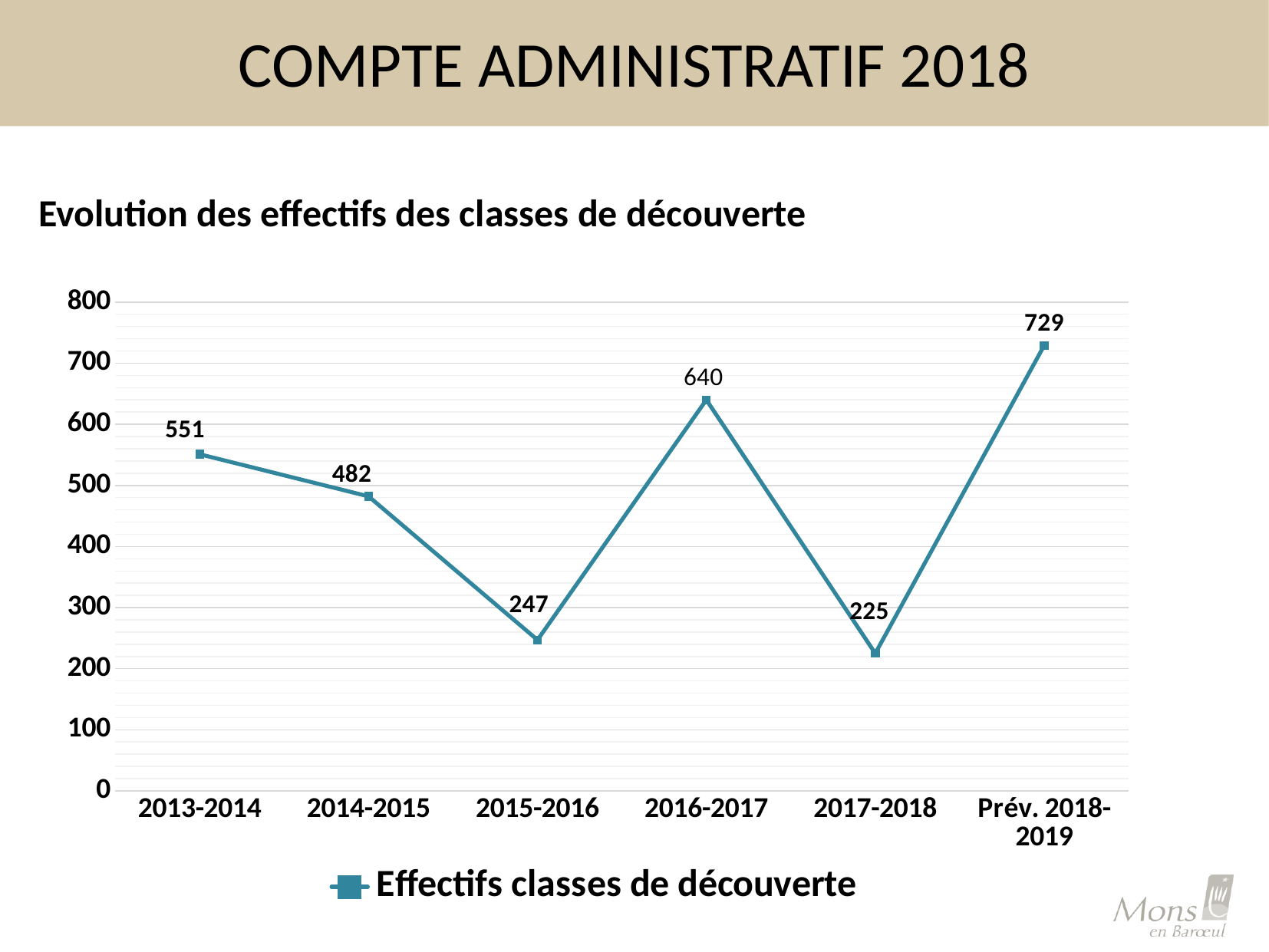
Is the value for 2015-2016 greater or less than 300? less How many periods are shown on the x axis? 6 What kind of chart is shown? line chart What is the difference between the values for 2016-2017 and 2015-2016? 393 What is the difference between the values for 2013-2014 and 2014-2015? 69 What is the value for 2013-2014? 551 What is the value for 2016-2017? 640 Which is larger, the value for 2014-2015 or the value for 2017-2018? 2014-2015 What is the value for Prév. 2018-2019? 729 Which period has the lowest value? 2017-2018 What is the legend entry for the plotted series? Effectifs classes de découverte Which period has the highest value? Prév. 2018-2019